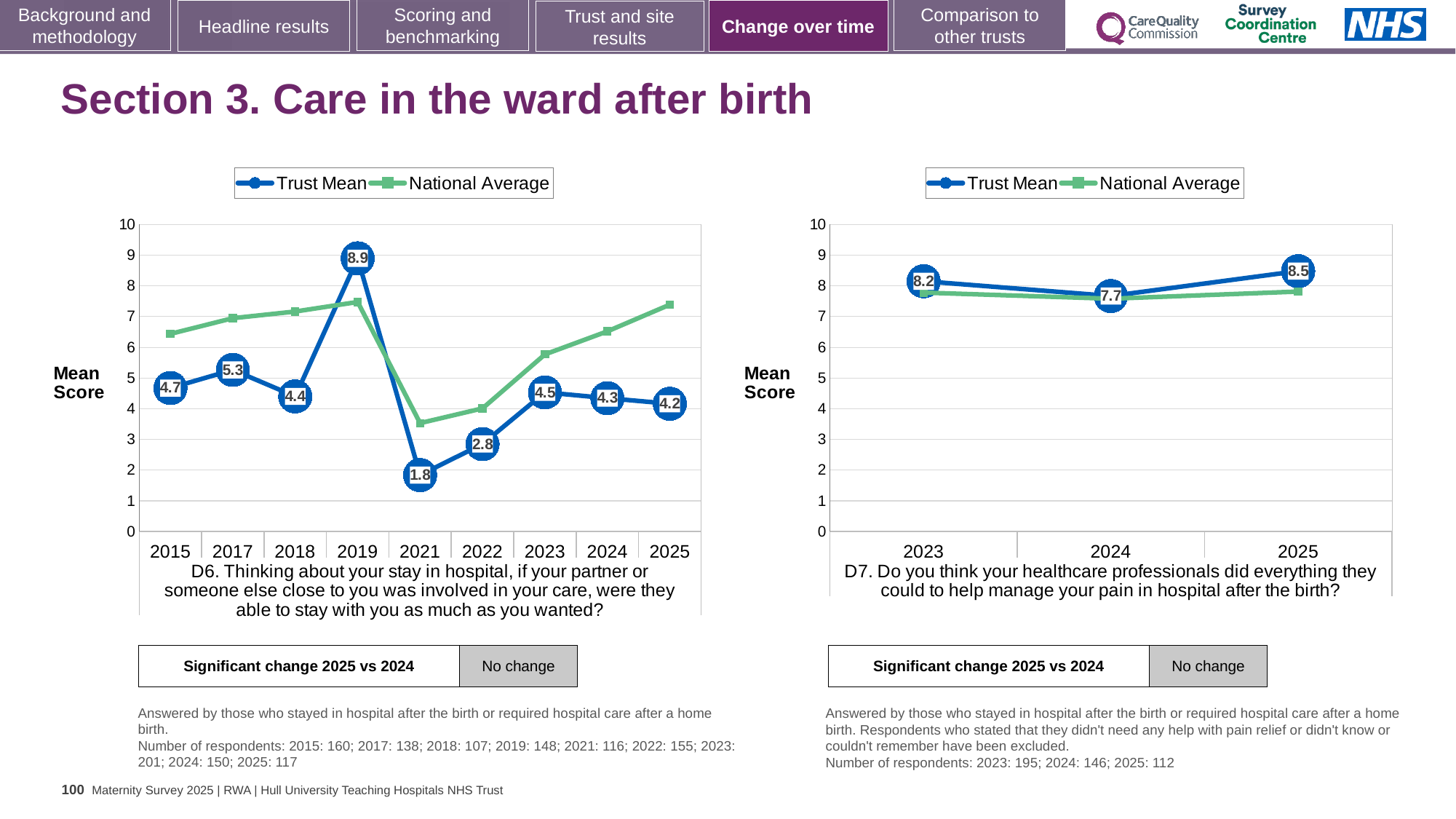
On the D7 chart (right), what is the Trust Mean score for 2025? 8.5 On the D6 chart (left), which year has the lowest Trust Mean score? 2021 On the D6 chart (left), which year has the highest Trust Mean score? 2019 On the D7 chart (right), which year has the lowest Trust Mean score? 2024 On the D6 chart (left), how many years are shown on the x axis? 9 On the D6 chart (left), what is the Trust Mean score for 2019? 8.9 What kind of chart is the D7 chart (right)? Line chart On the D6 chart (left), what is the Trust Mean score for 2021? 1.8 On the D7 chart (right), how many series does the legend list? 2 On the D6 chart (left), what is the difference between the Trust Mean scores for 2019 and 2021? 7.1 On the D6 chart (left), is the National Average for 2025 greater or less than 7? greater On the D7 chart (right), what is the difference between the Trust Mean scores for 2025 and 2024? 0.8